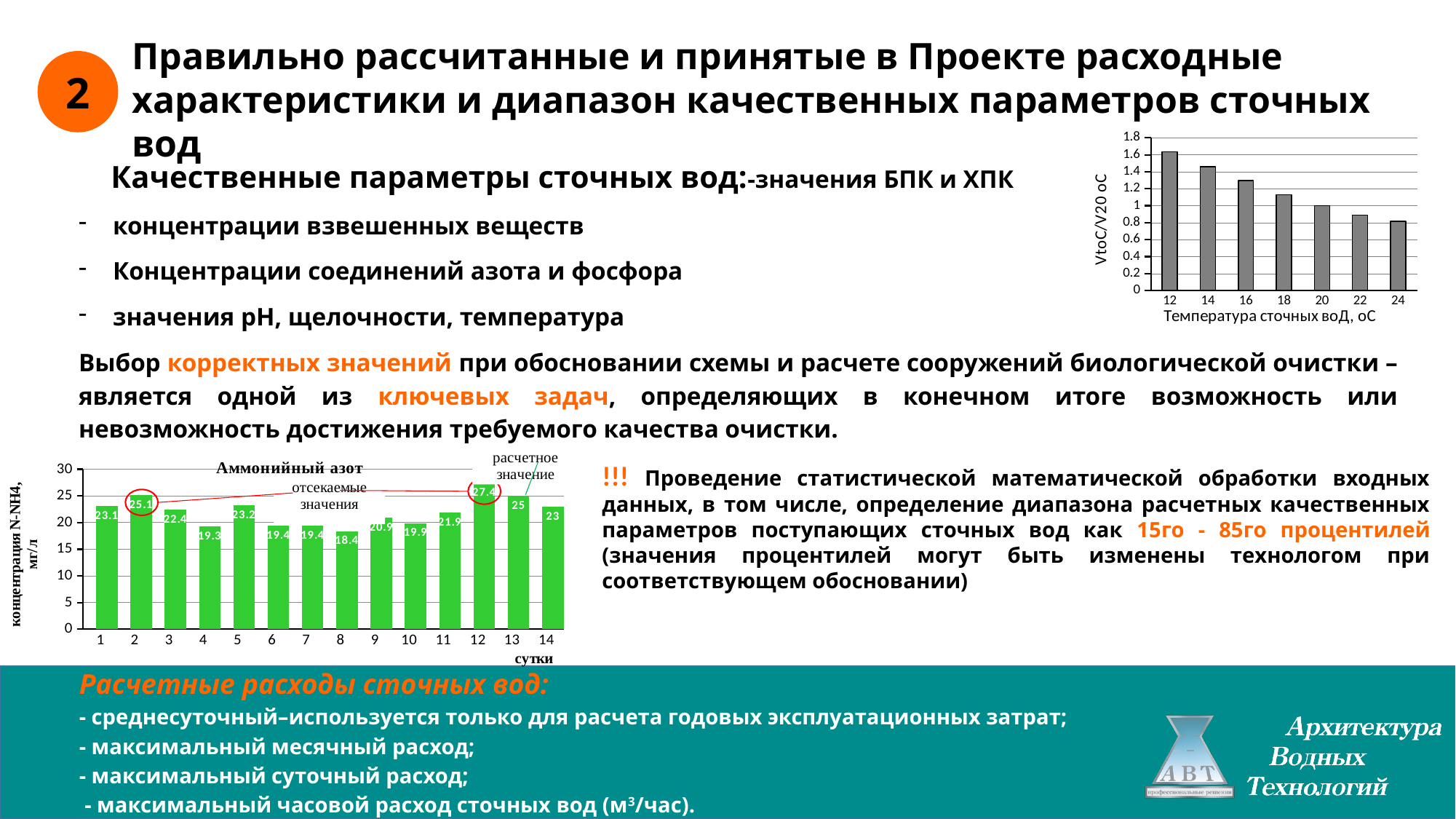
In the 'Аммонийный азот' chart, what is the value on day 12? 27.4 In the 'Аммонийный азот' chart, which day has the lowest value? 8 In the top-right chart (VtoC/V20 vs temperature), do the values rise or fall as temperature increases? fall In the top-right chart (VtoC/V20 vs temperature), is the value at 12 °C greater or less than 1.4? greater How many temperature categories are shown on the x axis of the top-right chart? 7 What kind of chart is the 'Аммонийный азот' chart? bar chart In the 'Аммонийный азот' chart, which is larger: the value on day 2 or the value on day 13? day 2 In the 'Аммонийный азот' chart, what is the value on day 8? 18.4 In the 'Аммонийный азот' chart, what is the difference between the values on day 12 and day 8? 9 In the top-right chart (VtoC/V20 vs temperature), is the value at 24 °C greater or less than 1? less In the 'Аммонийный азот' chart, which day has the highest value? 12 How many days (bars) are shown in the 'Аммонийный азот' chart? 14